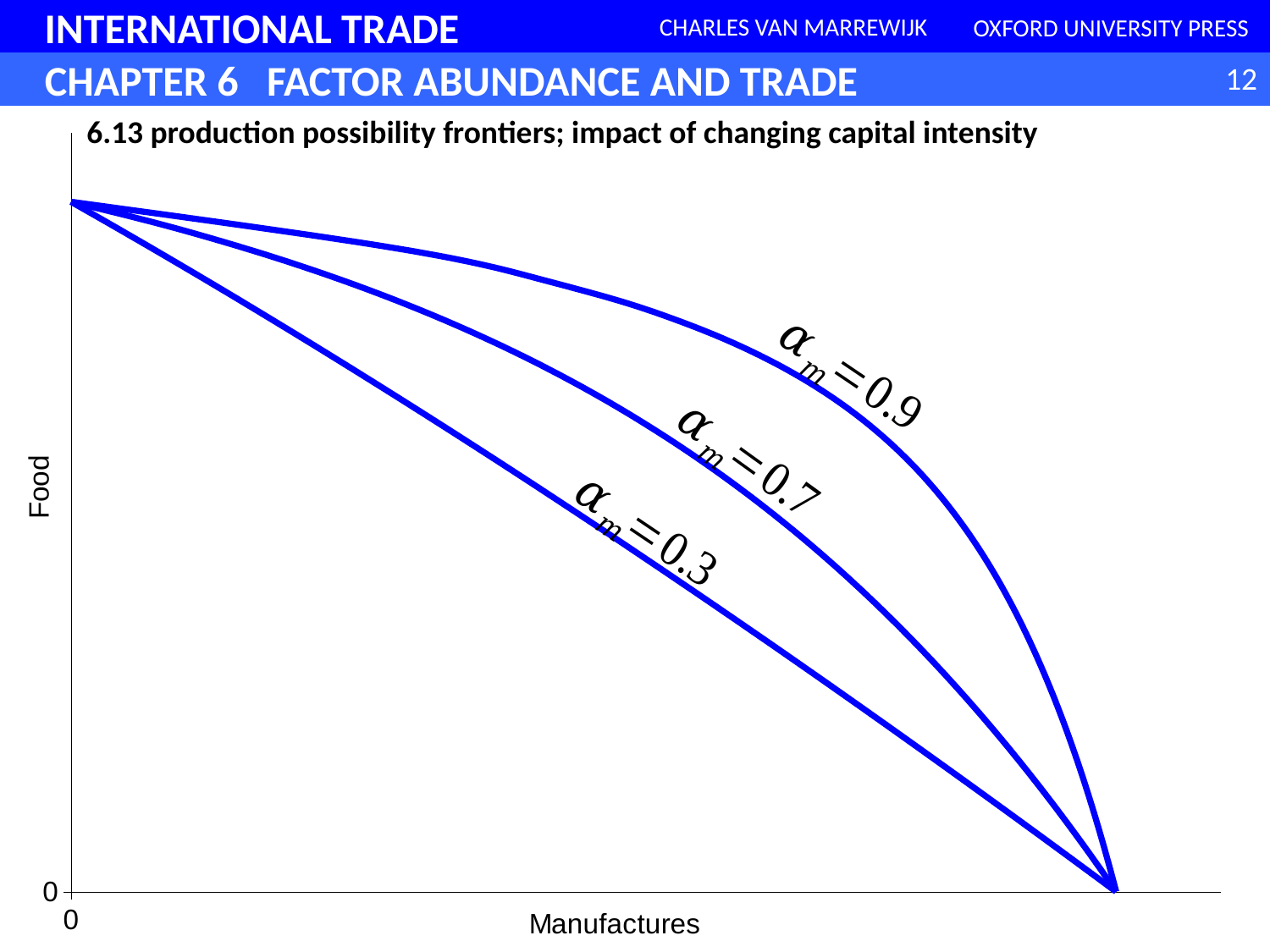
How many production possibility frontier curves are plotted on the chart? 3 What kind of chart is shown on the slide? Line chart As Manufactures increases along the x axis, does Food rise or fall along each curve? Fall In the middle of the chart, which curve is higher: αm = 0.9 or αm = 0.7? αm = 0.9 What is the label on the vertical axis of the chart? Food What is the title of the chart? 6.13 production possibility frontiers; impact of changing capital intensity What value is marked at the origin of the axes? 0 Which curve lies closest to the origin (lowest) in the middle of the chart? αm = 0.3 What is the label on the horizontal axis of the chart? Manufactures In the middle of the chart, which curve is higher: αm = 0.7 or αm = 0.3? αm = 0.7 Which curve lies furthest from the origin (highest) in the middle of the chart? αm = 0.9